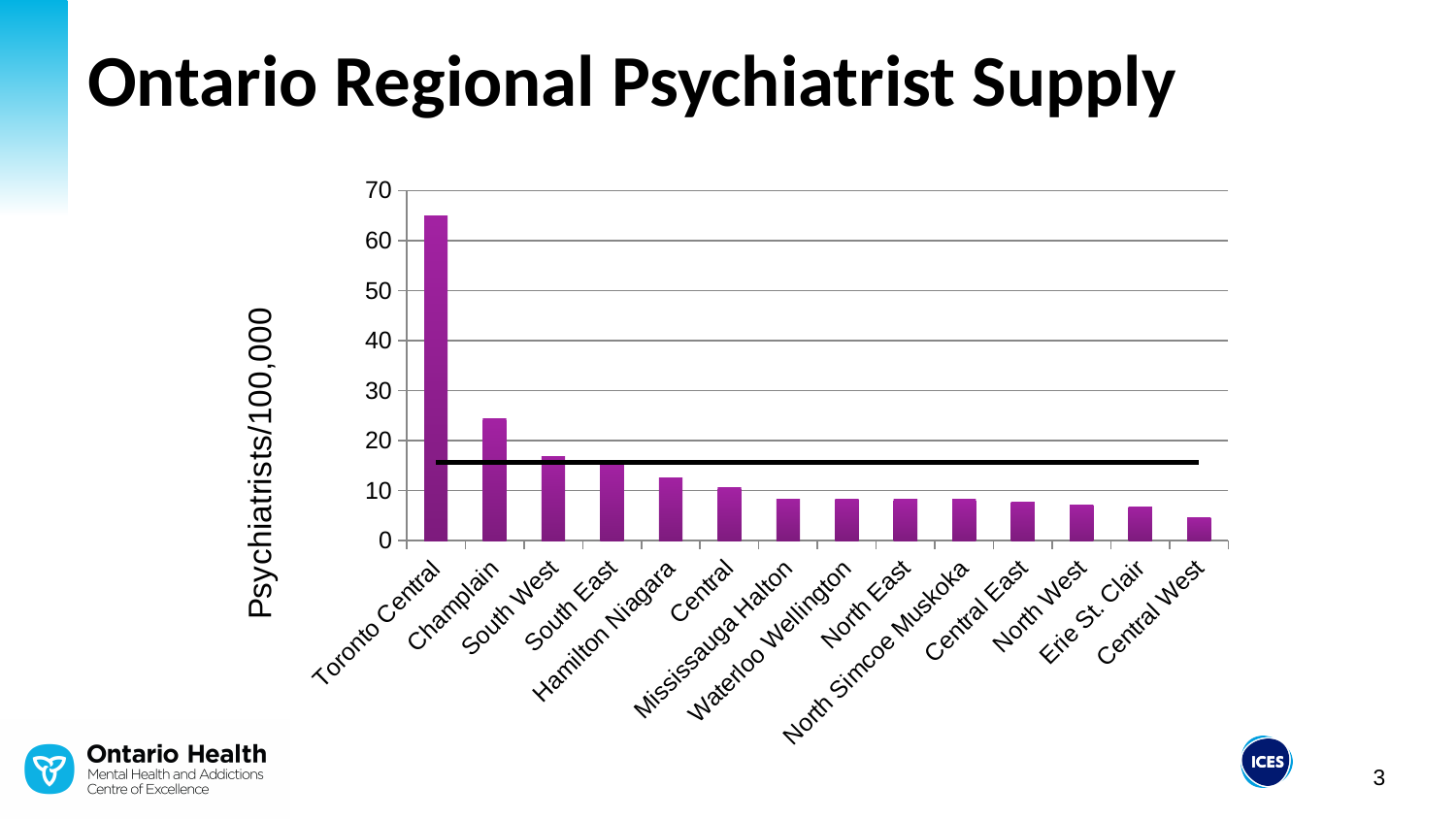
What kind of chart is shown on the slide? Bar chart Is the value for Hamilton Niagara greater or less than 10? greater Which region has the highest psychiatrist supply? Toronto Central Which has a higher value, Champlain or South West? Champlain Is the value for Champlain greater or less than 20? greater How many regions are plotted on the chart? 14 Do the bar values rise or fall from left to right along the x axis? Fall What is the label on the vertical axis? Psychiatrists/100,000 Is the value for Central West greater or less than 10? less Which region has the lowest psychiatrist supply? Central West Which has a higher value, Toronto Central or Champlain? Toronto Central